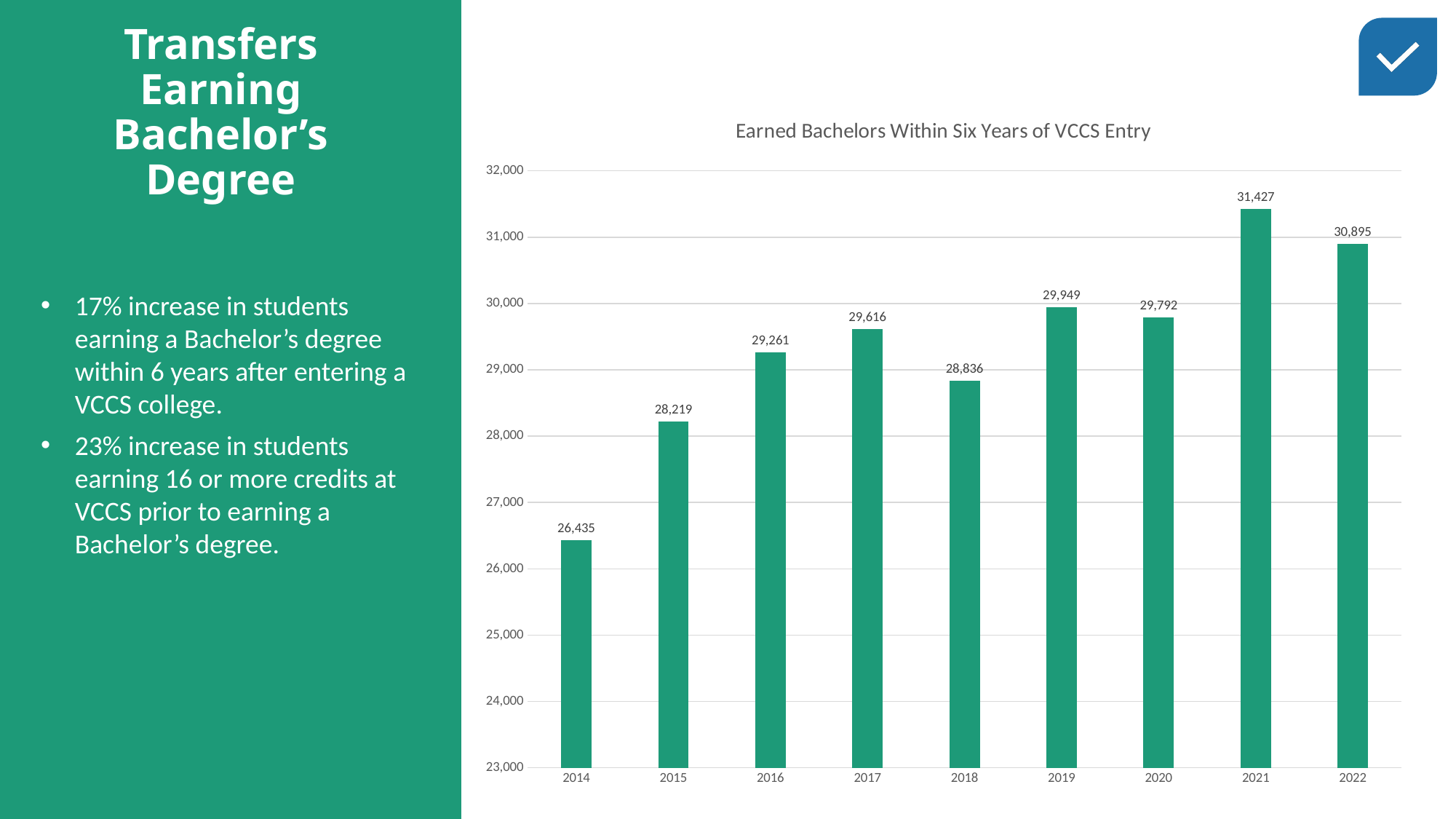
What is the difference between the values for 2021 and 2014? 4,992 How many years are shown on the x axis? 9 What is the title of the chart? Earned Bachelors Within Six Years of VCCS Entry What is the value for 2022? 30,895 Which year has the lowest value? 2014 Is the value for 2016 greater or less than 29,000? greater What is the value for 2018? 28,836 Which is larger, the value for 2017 or the value for 2018? 2017 Which year has the highest value? 2021 What is the value for 2014? 26,435 What is the difference between the values for 2019 and 2018? 1,113 What kind of chart is this? bar chart